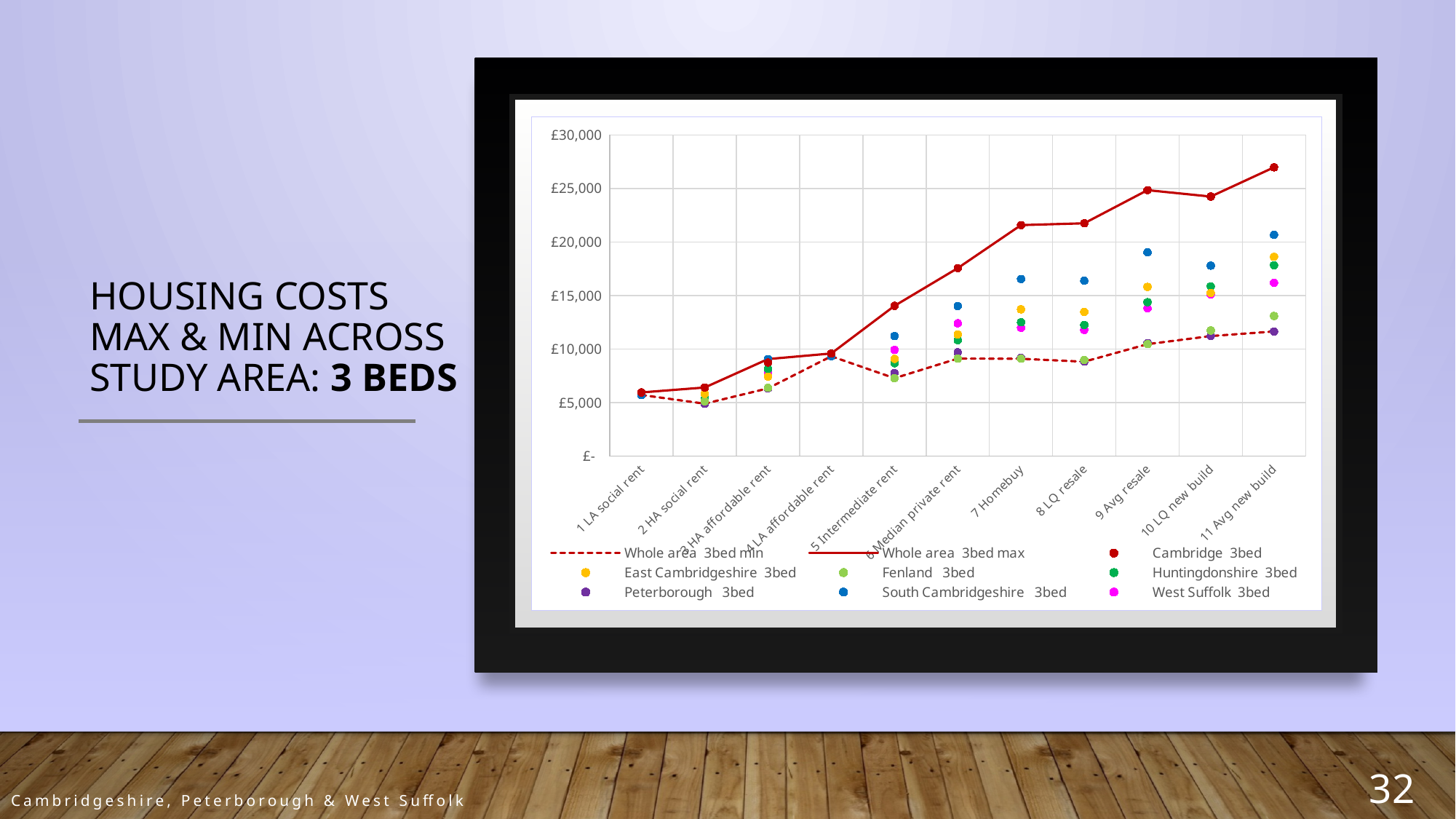
How many categories are shown along the x axis of the chart? 11 Does the Whole area 3bed max series generally rise or fall from left to right along the x axis? rise Is the value of Whole area 3bed max for 7 Homebuy greater or less than £20,000? greater Is the value of Whole area 3bed max for 11 Avg new build greater or less than £25,000? greater For which category is the Whole area 3bed max value highest? 11 Avg new build Which legend series is drawn as a dashed line? Whole area 3bed min Is the value of Whole area 3bed min for 2 HA social rent greater or less than £10,000? less Which is larger for Whole area 3bed max: 8 LQ resale or 11 Avg new build? 11 Avg new build For which category is the Whole area 3bed max value lowest? 1 LA social rent How many series does the chart's legend list? 9 What kind of chart is shown on the slide? line chart